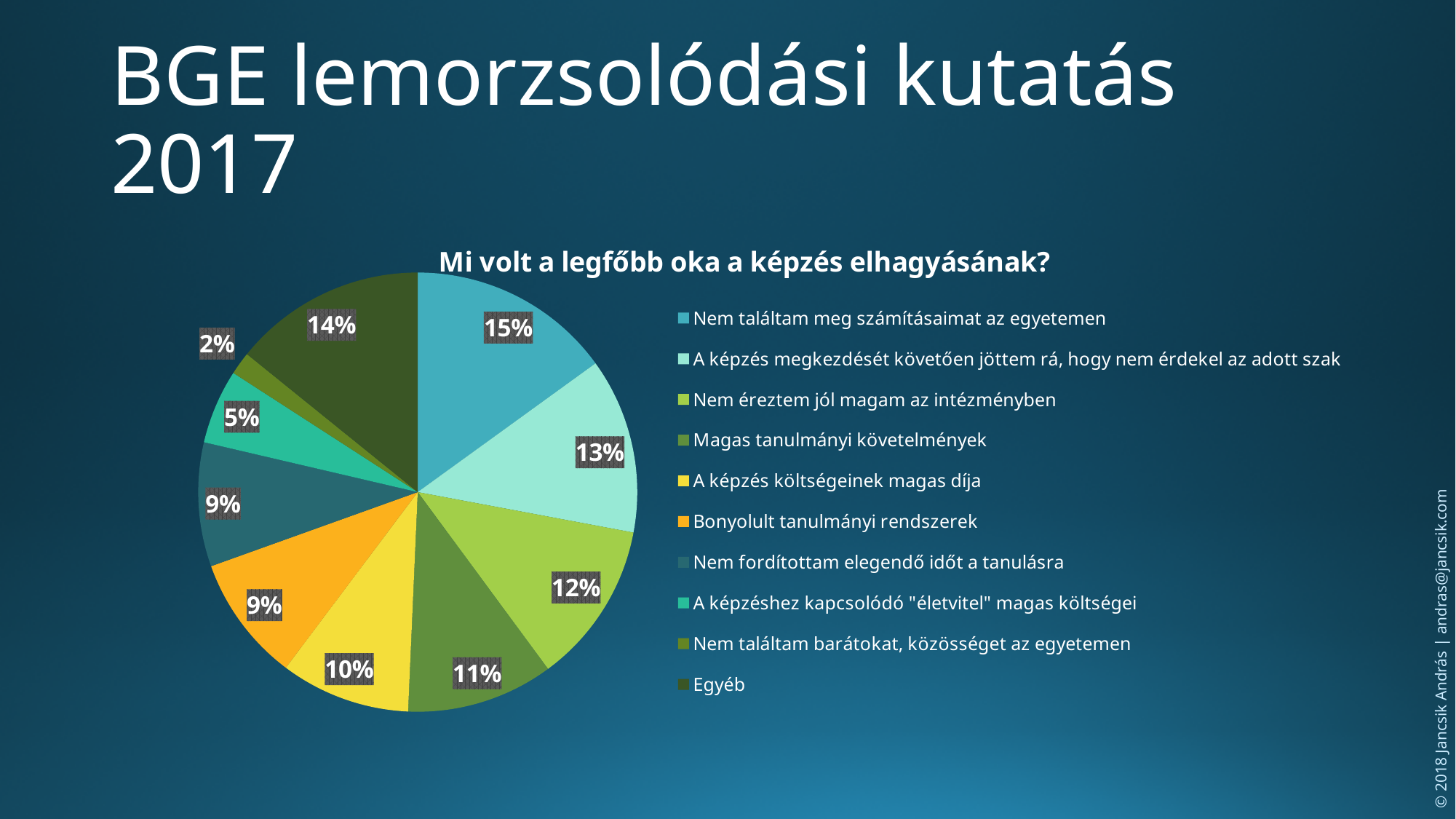
Which category has the smallest slice of the pie? Nem találtam barátokat, közösséget az egyetemen What share of the pie is labelled "Egyéb"? 14% What is the title of the chart? Mi volt a legfőbb oka a képzés elhagyásának? What share of the pie is labelled "A képzés megkezdését követően jöttem rá, hogy nem érdekel az adott szak"? 13% What is the difference in percentage points between "Nem éreztem jól magam az intézményben" and "A képzéshez kapcsolódó "életvitel" magas költségei"? 7 percentage points What share of the pie is labelled "Nem találtam barátokat, közösséget az egyetemen"? 2% What kind of chart is shown on the slide? pie chart Which is larger: the slice for "Magas tanulmányi követelmények" or the slice for "Bonyolult tanulmányi rendszerek"? Magas tanulmányi követelmények What share of the pie is labelled "Nem találtam meg számításaimat az egyetemen"? 15% What share of the pie is labelled "A képzés költségeinek magas díja"? 10% How many categories does the legend of the pie chart list? 10 Which category has the largest slice of the pie? Nem találtam meg számításaimat az egyetemen